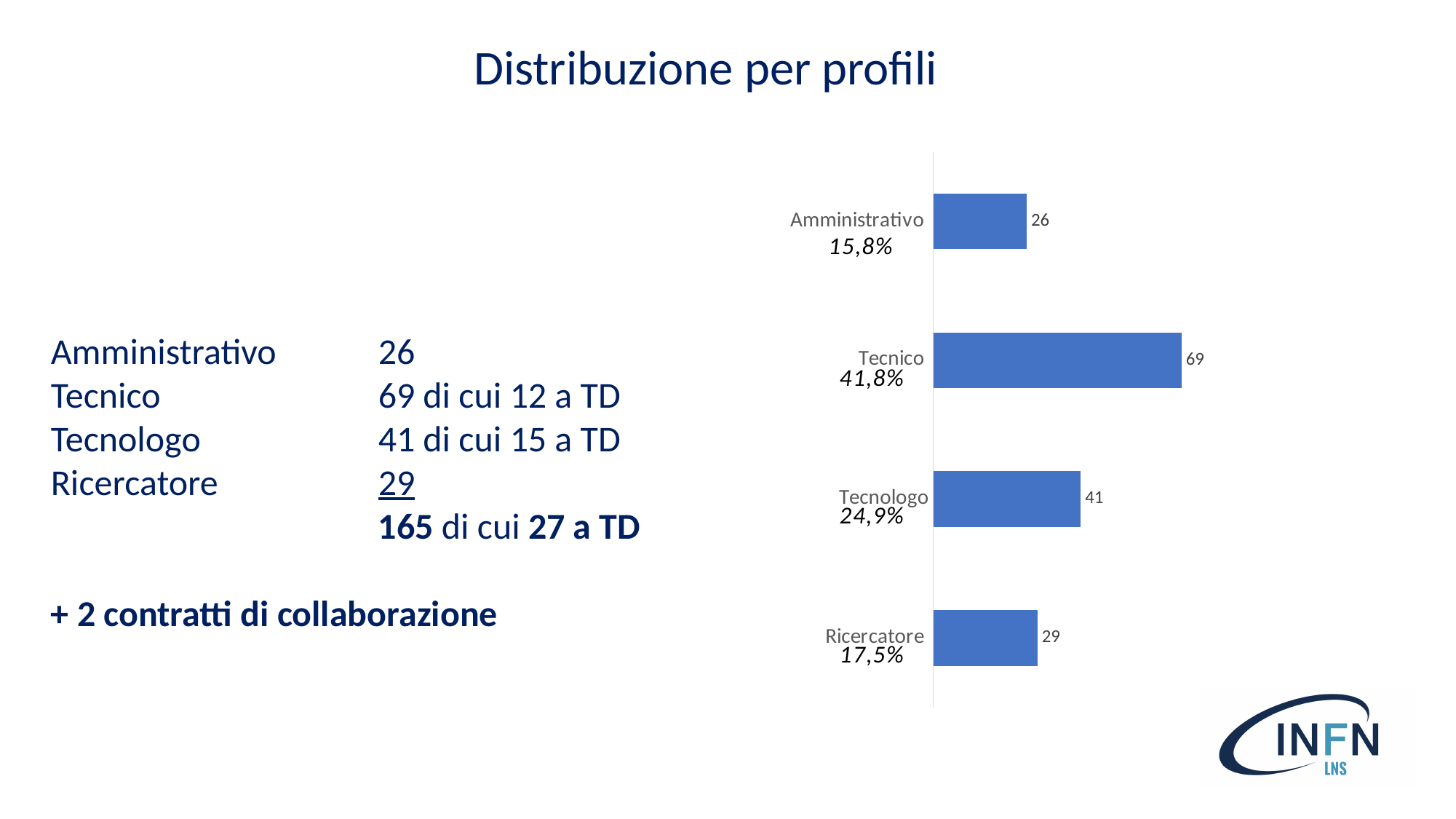
What is the value for Tecnologo in the bar chart? 41 Which category has the highest value in the bar chart? Tecnico Which category has the lowest value in the bar chart? Amministrativo What is the difference between the values for Tecnico and Tecnologo? 28 What is the value for Amministrativo in the bar chart? 26 What is the value for Tecnico in the bar chart? 69 What is the value for Ricercatore in the bar chart? 29 How many categories are shown in the bar chart? 4 What kind of chart is shown on the slide? Bar chart What is the title of the slide containing the chart? Distribuzione per profili Which is larger, the value for Ricercatore or the value for Amministrativo? Ricercatore What percentage is shown next to the Tecnico label in the chart? 41,8%